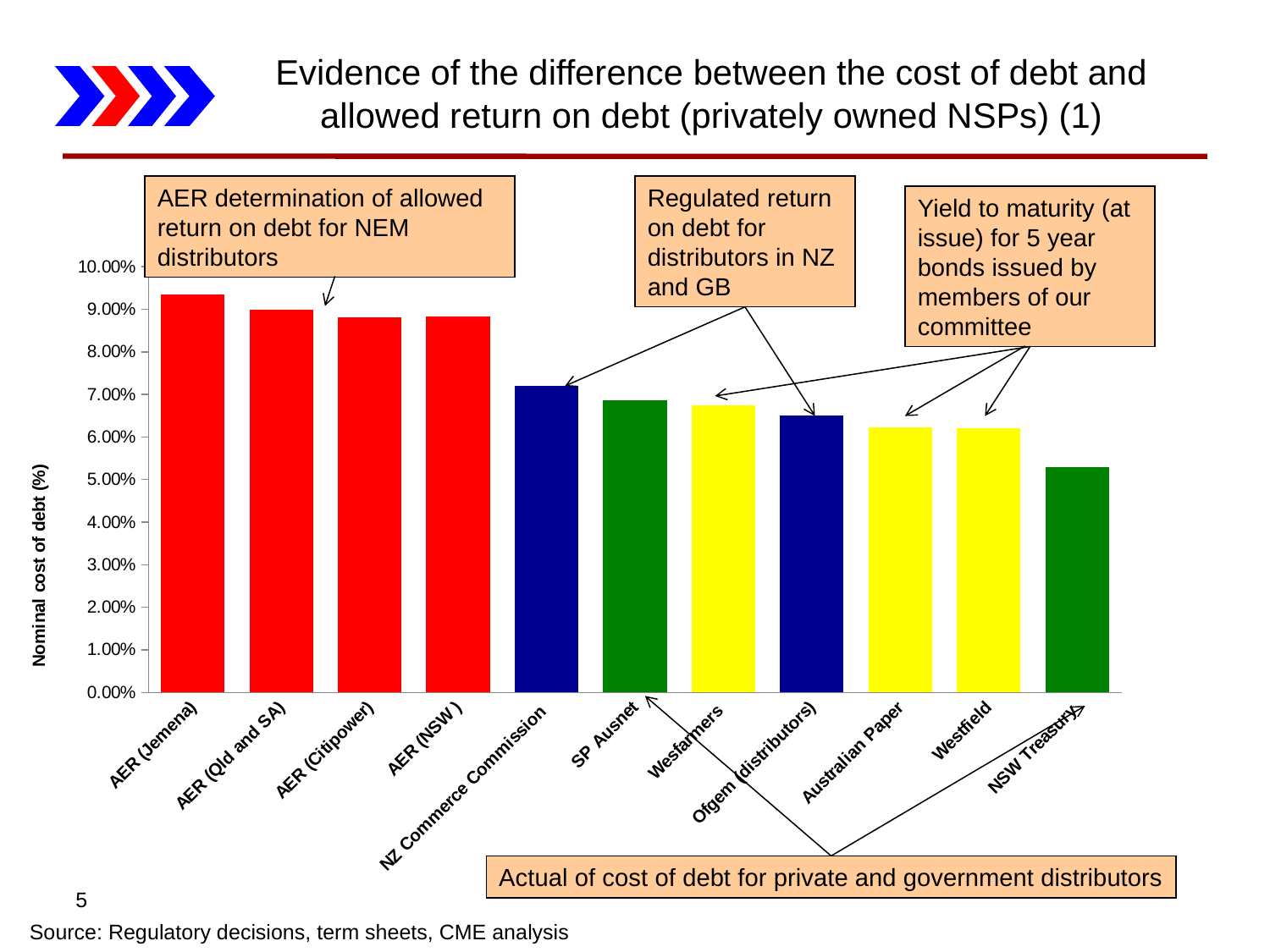
Which category has the highest nominal cost of debt? AER (Jemena) How many categories (bars) are plotted in the chart? 11 Do the values generally rise or fall moving from left to right along the x axis? fall Is the value for AER (Jemena) greater or less than 9.00%? greater Which category has the lowest nominal cost of debt? NSW Treasury What is the title of the vertical axis? Nominal cost of debt (%) What kind of chart is shown on the slide? bar chart Is the value for NSW Treasury greater or less than 5.00%? greater Is the value for NZ Commerce Commission greater or less than 8.00%? less Which is larger, the value for AER (Jemena) or the value for AER (Qld and SA)? AER (Jemena) Which is larger, the value for NZ Commerce Commission or the value for Ofgem (distributors)? NZ Commerce Commission